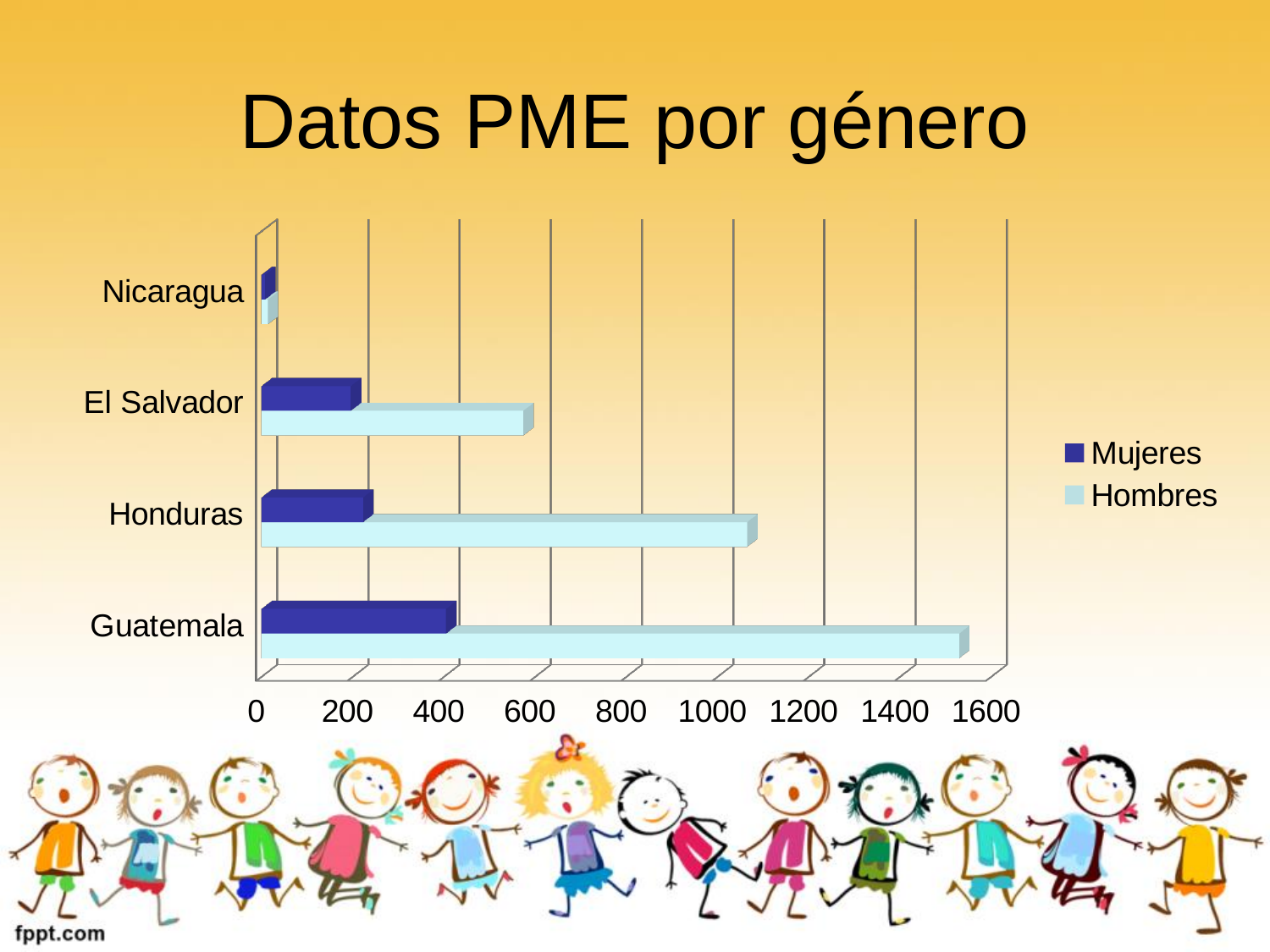
How many series does the legend list? 2 What kind of chart is shown on the slide? bar chart Is the Hombres value for Honduras greater or less than 1000? greater Which country has the lowest value for Hombres? Nicaragua Which country has the highest value for Mujeres? Guatemala What is the title of the chart? Datos PME por género How many countries are shown on the chart? 4 Which is larger, the Hombres value for Guatemala or the Hombres value for Honduras? Guatemala Which series is shown in dark blue in the legend? Mujeres Is the Hombres value for Guatemala greater or less than 1400? greater Which country has the highest value for Hombres? Guatemala Is the Hombres value for El Salvador greater or less than 800? less